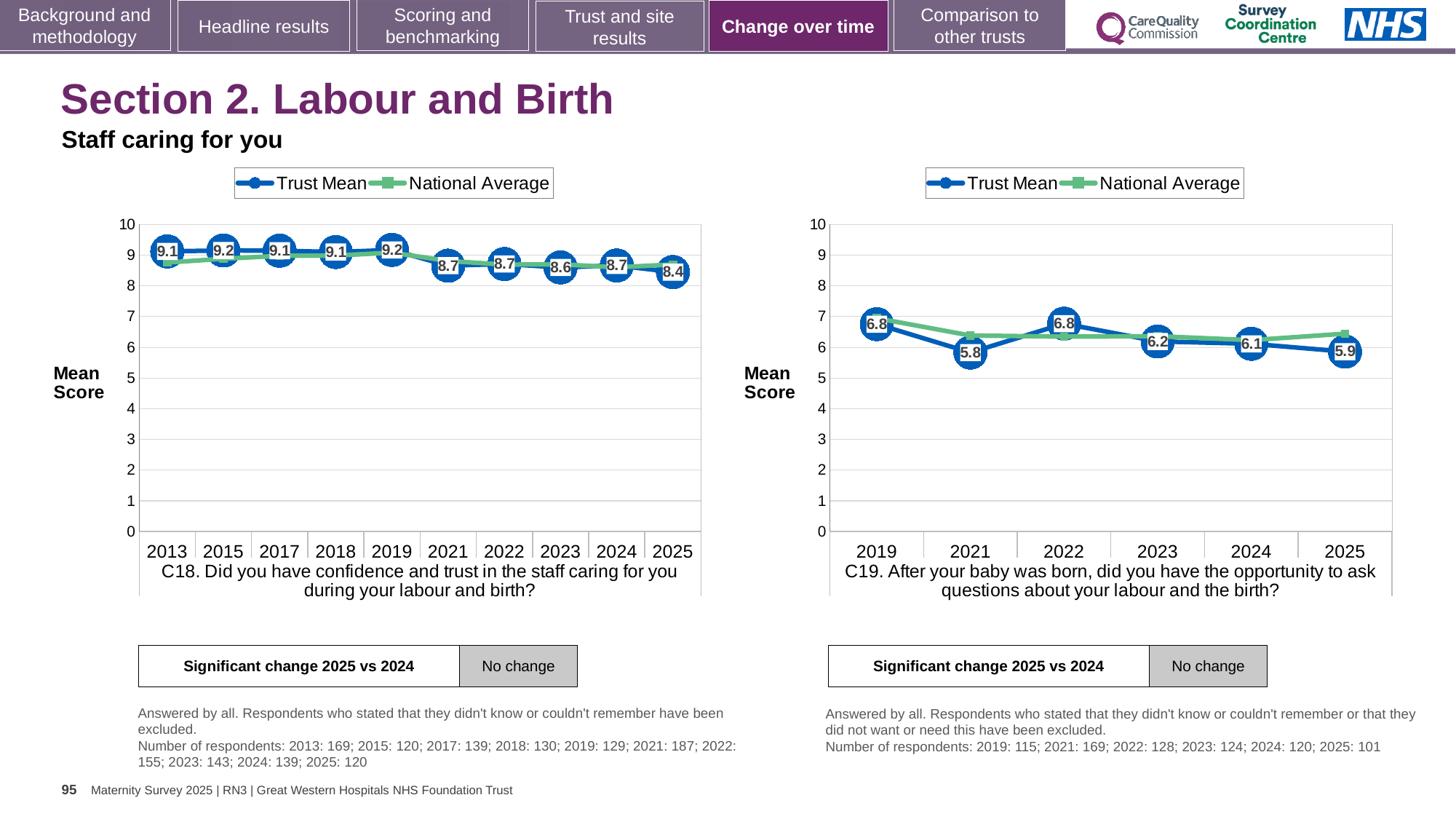
In the left chart (C18), what is the Trust Mean score for 2019? 9.2 In the right chart (C19), which year has the lowest Trust Mean score? 2021 How many years are plotted in the left chart (C18)? 10 How many series does the legend of the right chart (C19) list? 2 What kind of chart is the left chart (C18)? Line chart In the right chart (C19), what is the Trust Mean score for 2025? 5.9 In the right chart (C19), what is the Trust Mean score for 2021? 5.8 In the right chart (C19), which is larger, the Trust Mean score for 2023 or for 2024? 2023 In the left chart (C18), which year has the lowest Trust Mean score? 2025 In the right chart (C19), is the National Average value for 2021 greater or less than 6? greater In the left chart (C18), what is the difference between the Trust Mean scores for 2013 and 2025? 0.7 In the left chart (C18), what is the Trust Mean score for 2025? 8.4